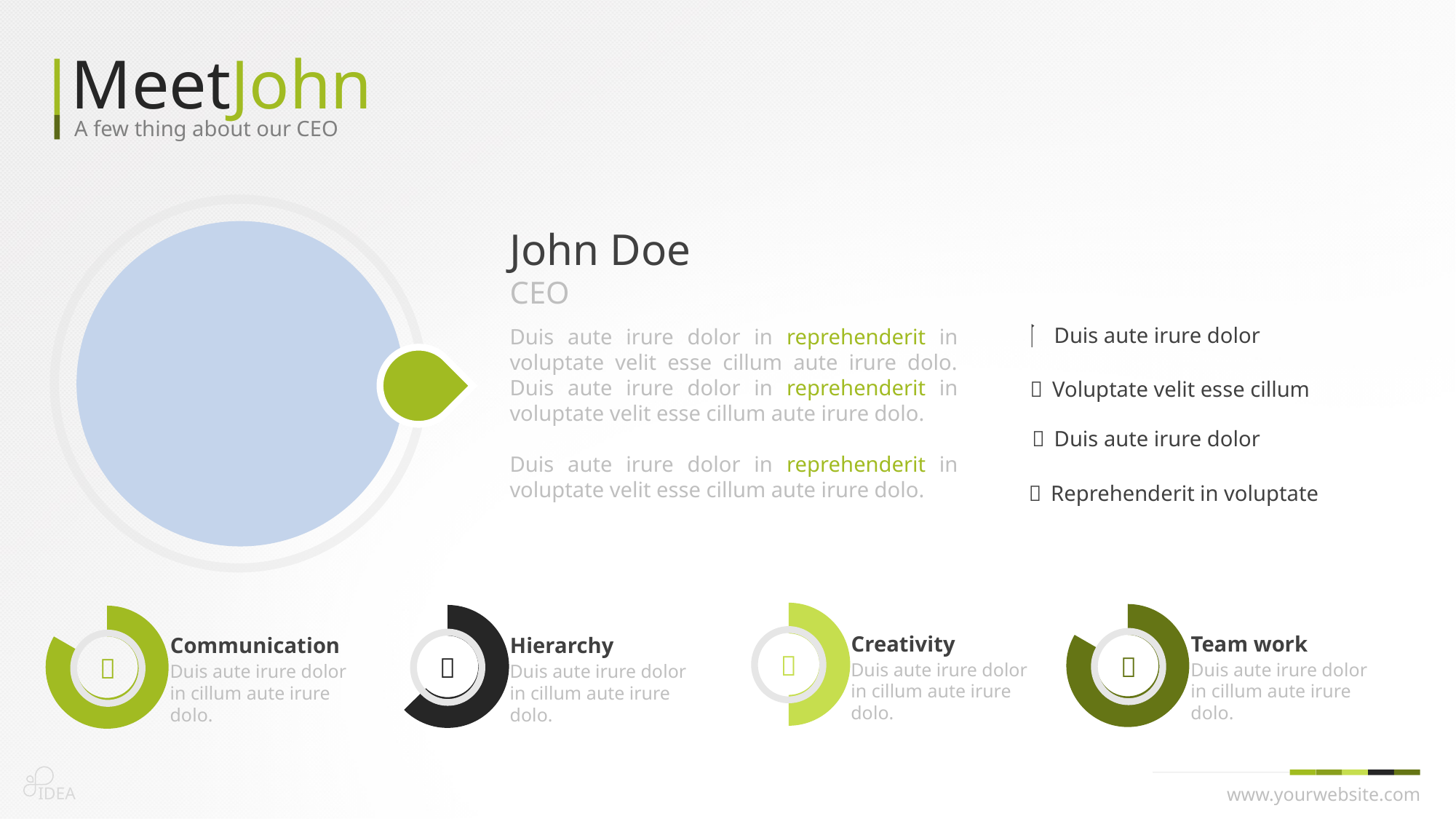
Which ring chart is more filled, Communication or Hierarchy? Communication What kind of chart is used for the Communication, Hierarchy, Creativity and Team work indicators at the bottom of the slide? Doughnut (ring) chart What is the label of the ring chart drawn in dark grey/black at the bottom of the slide? Hierarchy What is the label of the first ring chart on the left at the bottom of the slide? Communication How many ring charts are shown along the bottom of the slide? 4 Which ring chart is more filled, Team work or Creativity? Team work